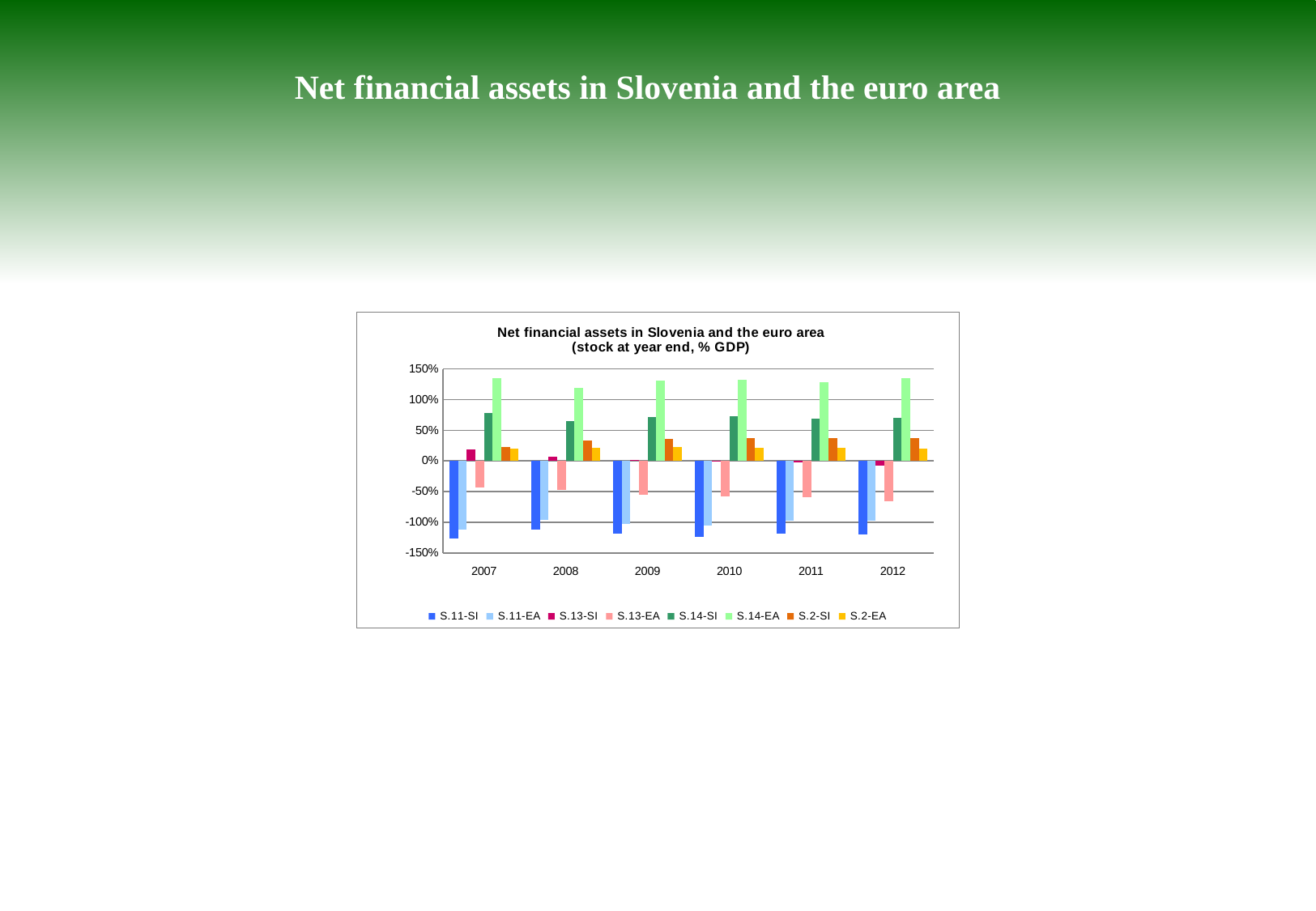
What unit does the chart subtitle say the values are expressed in? % GDP Is the value for S.14-SI in 2008 greater or less than 50%? greater Is the value for S.13-EA in 2012 greater or less than -50%? less What kind of chart is shown on the slide? bar chart Is the value for S.11-SI in 2007 greater or less than -100%? less In 2010, which is larger: S.14-EA or S.14-SI? S.14-EA Which series has the lowest value in 2007? S.11-SI How many years are shown on the x axis? 6 Does the value for S.13-EA rise or fall from 2007 to 2012? fall How many series does the legend list? 8 Which series has the highest value in 2012? S.14-EA